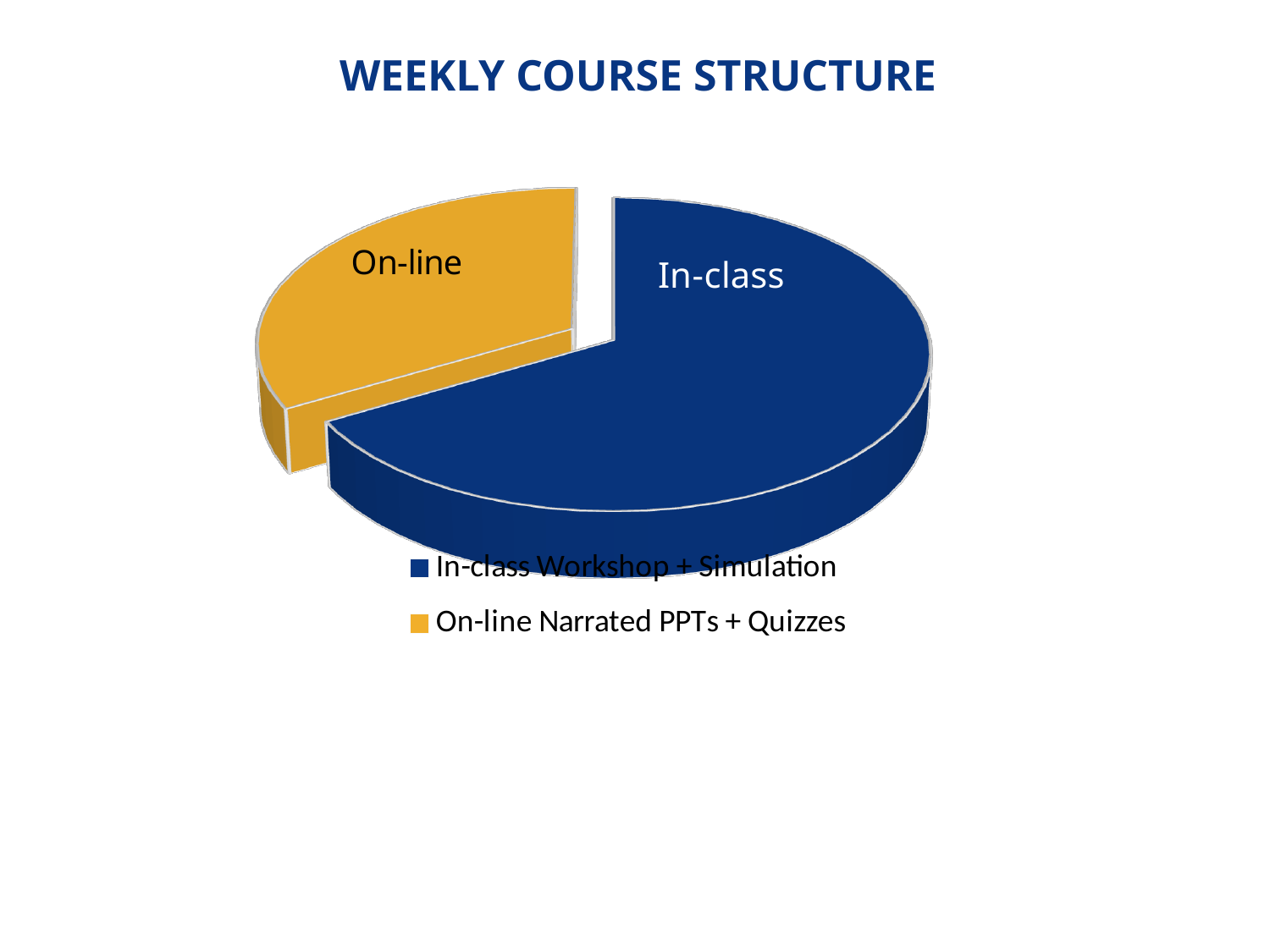
How many slices does the pie chart have? 2 Which slice is larger, In-class or On-line? In-class How many entries does the legend list? 2 What colour is the In-class slice? blue What is the full legend label for the On-line slice? On-line Narrated PPTs + Quizzes What type of chart is shown on the slide? pie chart Which slice is the largest? In-class Which slice is the smallest? On-line What is the title of the chart? WEEKLY COURSE STRUCTURE What is the full legend label for the In-class slice? In-class Workshop + Simulation